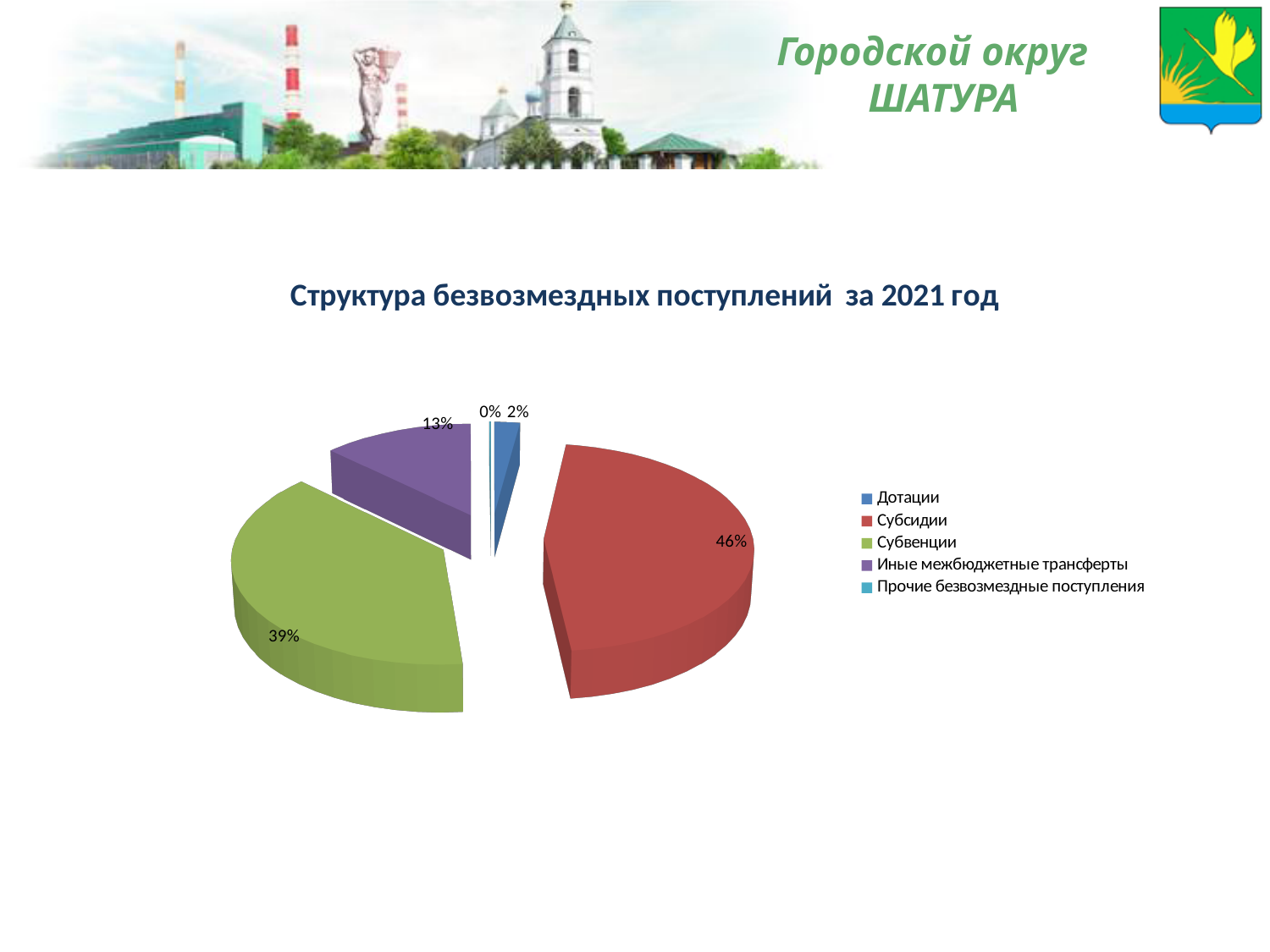
What share of the pie does Субсидии have? 46% What is the title of the chart? Структура безвозмездных поступлений за 2021 год What share of the pie does Иные межбюджетные трансферты have? 13% What share of the pie does Дотации have? 2% How many categories does the legend list? 5 Which is larger, the share of Субвенции or the share of Иные межбюджетные трансферты? Субвенции Which category has the largest share of the pie? Субсидии Which category has the smallest share of the pie? Прочие безвозмездные поступления What kind of chart is shown on the slide? pie chart What is the difference between the shares of Субсидии and Субвенции? 7%